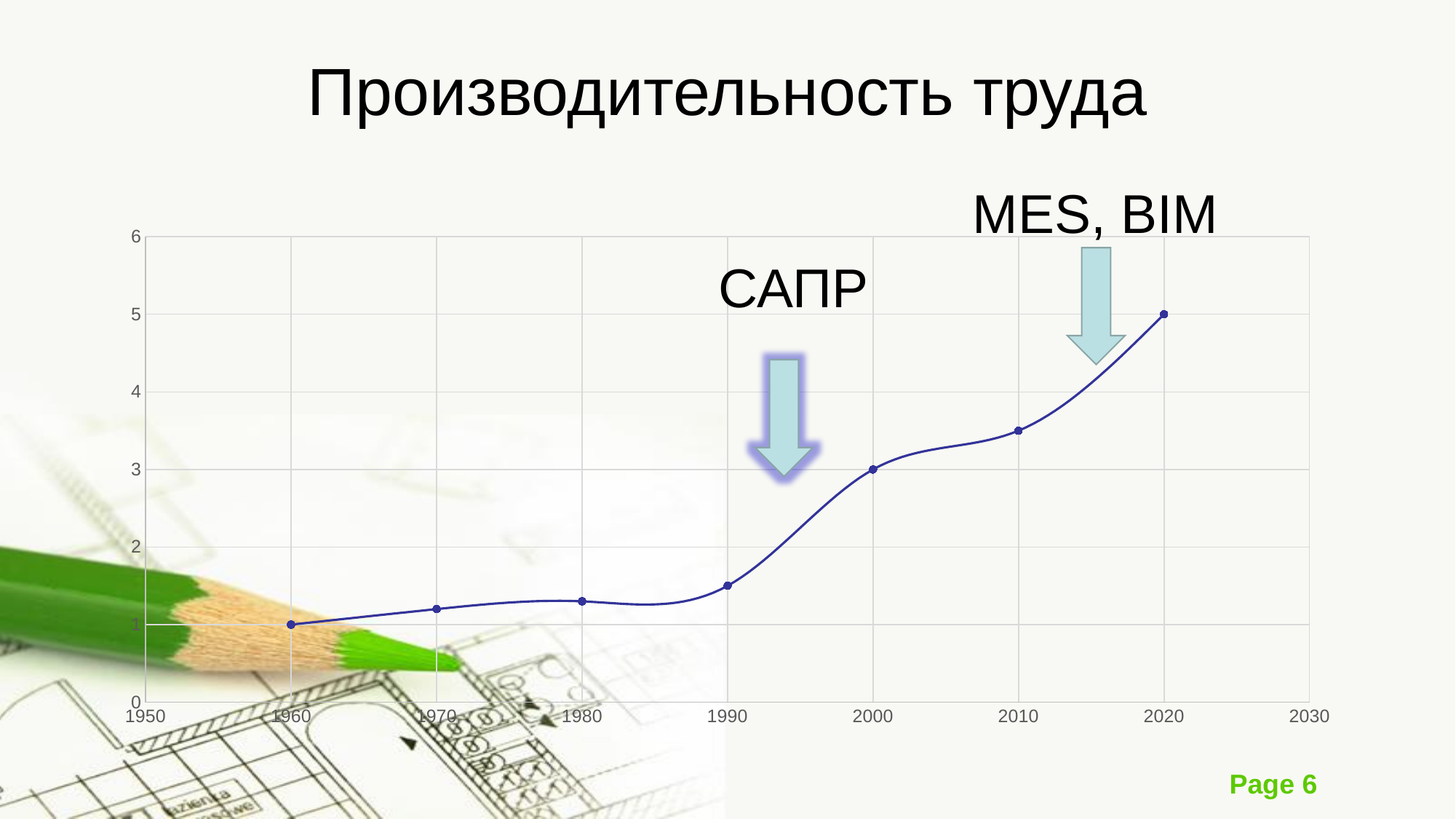
Which year has the highest plotted value? 2020 What is the difference between the values for 2020 and 1960? 4 Which year has the lowest plotted value? 1960 How many data points are plotted on the line? 7 Is the value for 1990 greater or less than 2? less What is the value plotted for 2020? 5 Do the values rise or fall from 1960 to 2020? rise What kind of chart is shown on the slide? line chart What is the title of the chart on the slide? Производительность труда What is the value plotted for 2000? 3 Is the value for 2010 greater or less than 3? greater What is the value plotted for 1960? 1